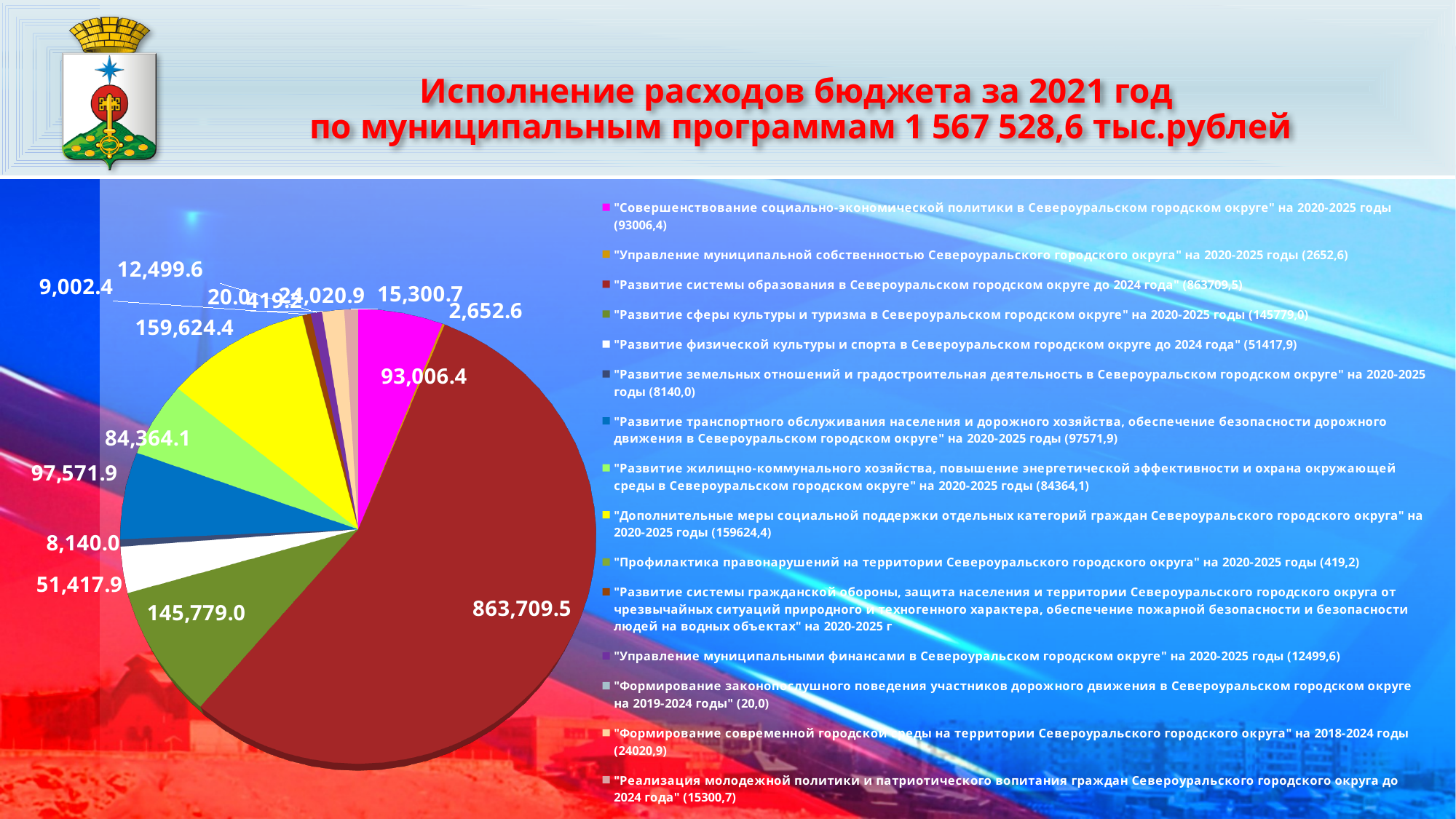
How many programmes (slices) are shown in the pie chart? 15 What is the value shown for the programme "Развитие сферы культуры и туризма в Североуральском городском округе"? 145,779.0 What is the value shown for the programme "Формирование современной городской среды на территории Североуральского городского округа"? 24,020.9 Which programme has the largest slice of the pie? "Развитие системы образования в Североуральском городском округе до 2024 года" What colour is the slice for "Совершенствование социально-экономической политики в Североуральском городском округе"? magenta (pink) Which programme has the smallest value in the pie chart? "Формирование законопослушного поведения участников дорожного движения в Североуральском городском округе на 2019-2024 годы" (20.0) What is the difference between the values for "Дополнительные меры социальной поддержки отдельных категорий граждан" (159,624.4) and "Развитие сферы культуры и туризма" (145,779.0)? 13,845.4 What is the value shown for the programme "Развитие системы образования в Североуральском городском округе до 2024 года"? 863,709.5 What share of the total 1 567 528,6 тыс.рублей does the education programme (863,709.5) represent, to one decimal place? 55.1% What type of chart is shown on the slide? pie chart Which is larger: the value for "Развитие транспортного обслуживания населения и дорожного хозяйства" or the value for "Развитие жилищно-коммунального хозяйства"? "Развитие транспортного обслуживания населения и дорожного хозяйства" (97,571.9) What is the value shown for the programme "Управление муниципальной собственностью Североуральского городского округа"? 2,652.6